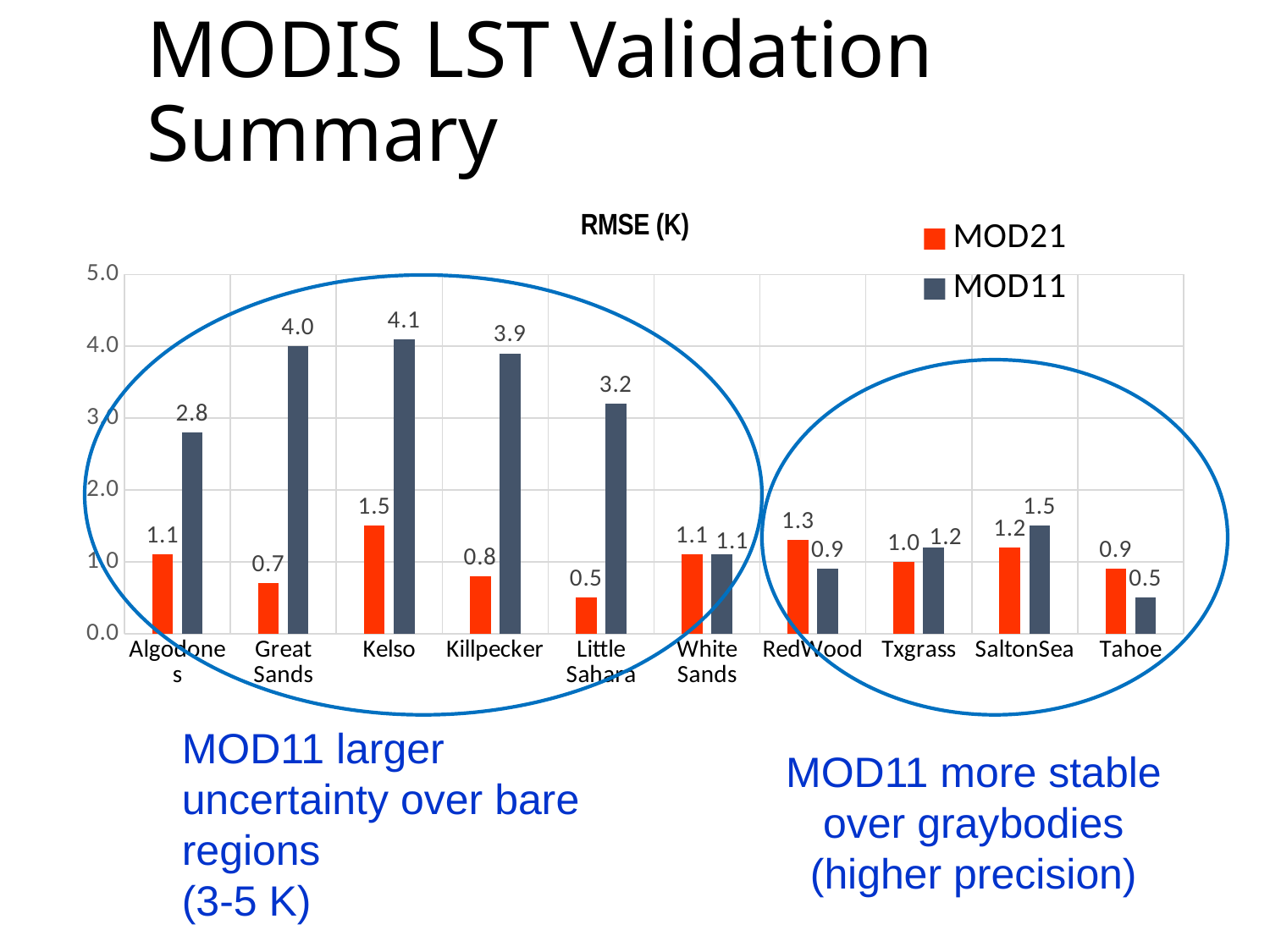
Which site has the lowest MOD21 RMSE? Little Sahara What is the title of the chart? RMSE (K) What is the MOD11 value for Tahoe? 0.5 What is the MOD21 RMSE value for Little Sahara? 0.5 What is the difference between the MOD11 and MOD21 values for Great Sands? 3.3 Is the MOD11 value for Killpecker greater or less than 3.0? greater What is the MOD11 RMSE value for Kelso? 4.1 Which is larger for RedWood, the MOD21 value or the MOD11 value? MOD21 How many sites are shown on the x axis? 10 How many series does the legend list? 2 What kind of chart is shown? bar chart Which site has the highest MOD11 RMSE? Kelso